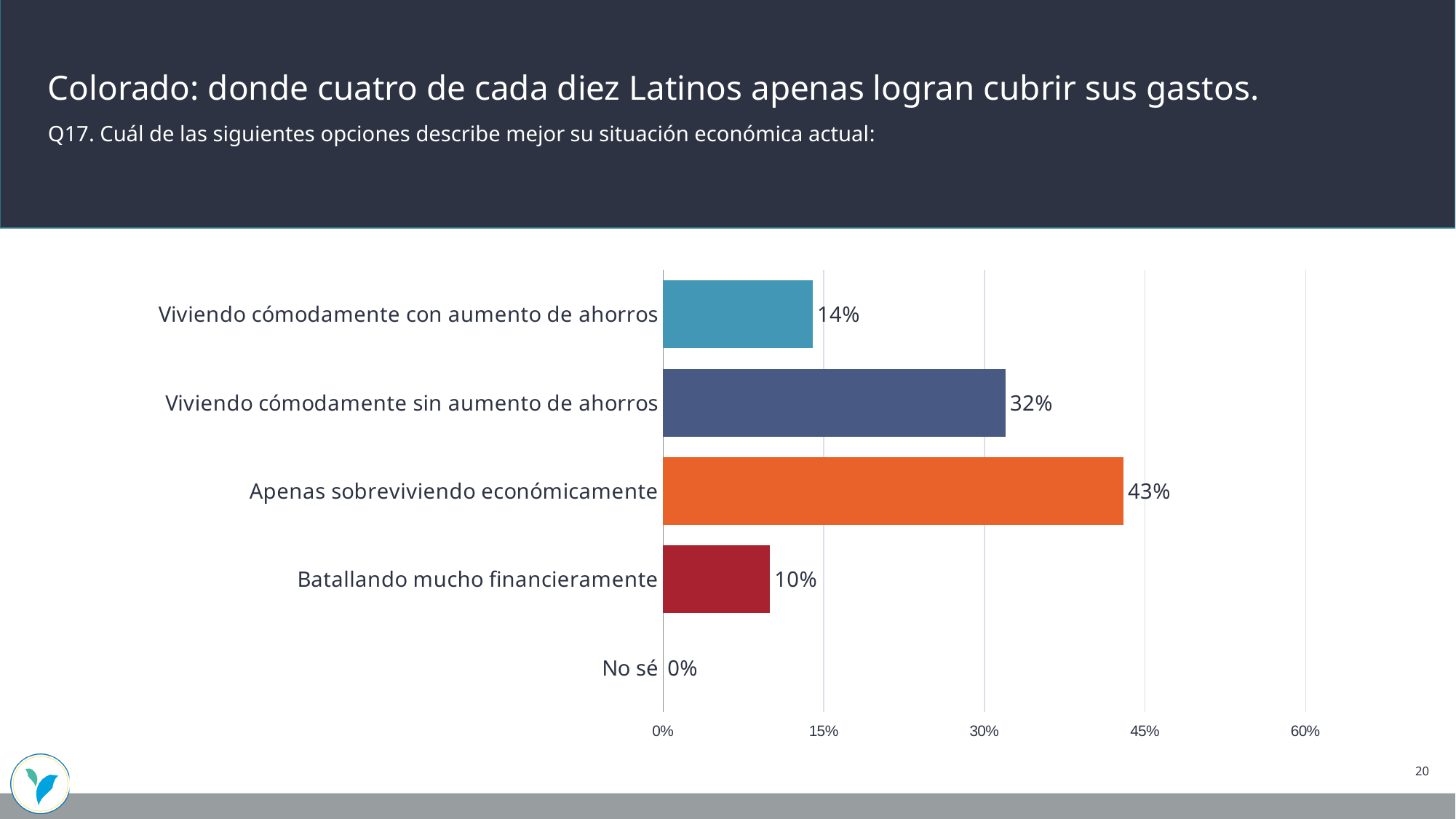
What is the highest value shown on the x axis? 60% What is the difference between "Apenas sobreviviendo económicamente" and "Viviendo cómodamente sin aumento de ahorros"? 11% How many categories are shown in the chart? 5 What is the value for "Apenas sobreviviendo económicamente"? 43% What kind of chart is shown on the slide? Bar chart What is the value for "No sé"? 0% Which is larger: "Viviendo cómodamente con aumento de ahorros" or "Batallando mucho financieramente"? Viviendo cómodamente con aumento de ahorros Which category has the lowest value? No sé What is the value for "Viviendo cómodamente con aumento de ahorros"? 14% Is the value for "Viviendo cómodamente sin aumento de ahorros" greater or less than 30%? greater What is the value for "Batallando mucho financieramente"? 10% Which category has the highest value? Apenas sobreviviendo económicamente